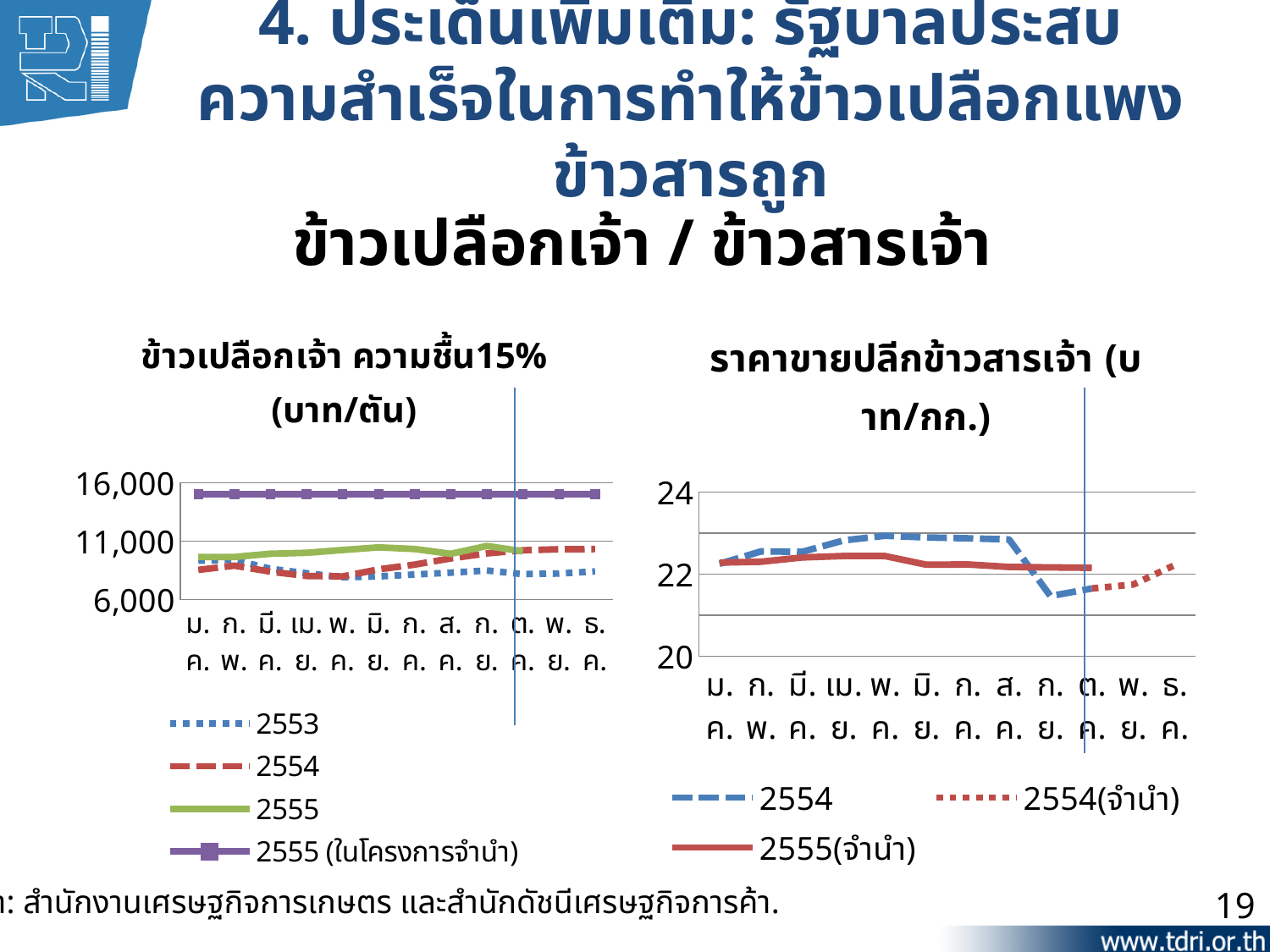
In the left chart (ข้าวเปลือกเจ้า ความชื้น15%), which series has the highest values across the year? 2555 (ในโครงการจำนำ) In the right chart (ราคาขายปลีกข้าวสารเจ้า), which series is higher in ก.ค.: 2554 or 2555(จำนำ)? 2554 In the left chart (ข้าวเปลือกเจ้า ความชื้น15%), does the 2555 (ในโครงการจำนำ) series rise, fall or stay flat across the months? stays flat In the left chart (ข้าวเปลือกเจ้า ความชื้น15%), is the value of the 2553 series in ม.ค. greater or less than 11,000? less What kind of chart is the left chart titled ข้าวเปลือกเจ้า ความชื้น15% (บาท/ตัน)? line chart In the left chart (ข้าวเปลือกเจ้า ความชื้น15%), is the value of the 2555 (ในโครงการจำนำ) series greater or less than 11,000? greater In the right chart (ราคาขายปลีกข้าวสารเจ้า), is the value of the 2554 series in ต.ค. greater or less than 22? less How many series does the legend of the left chart (ข้าวเปลือกเจ้า ความชื้น15%) list? 4 How many series does the legend of the right chart (ราคาขายปลีกข้าวสารเจ้า) list? 3 What kind of chart is the right chart titled ราคาขายปลีกข้าวสารเจ้า (บาท/กก.)? line chart How many months are shown on the x axis of the left chart (ข้าวเปลือกเจ้า ความชื้น15%)? 12